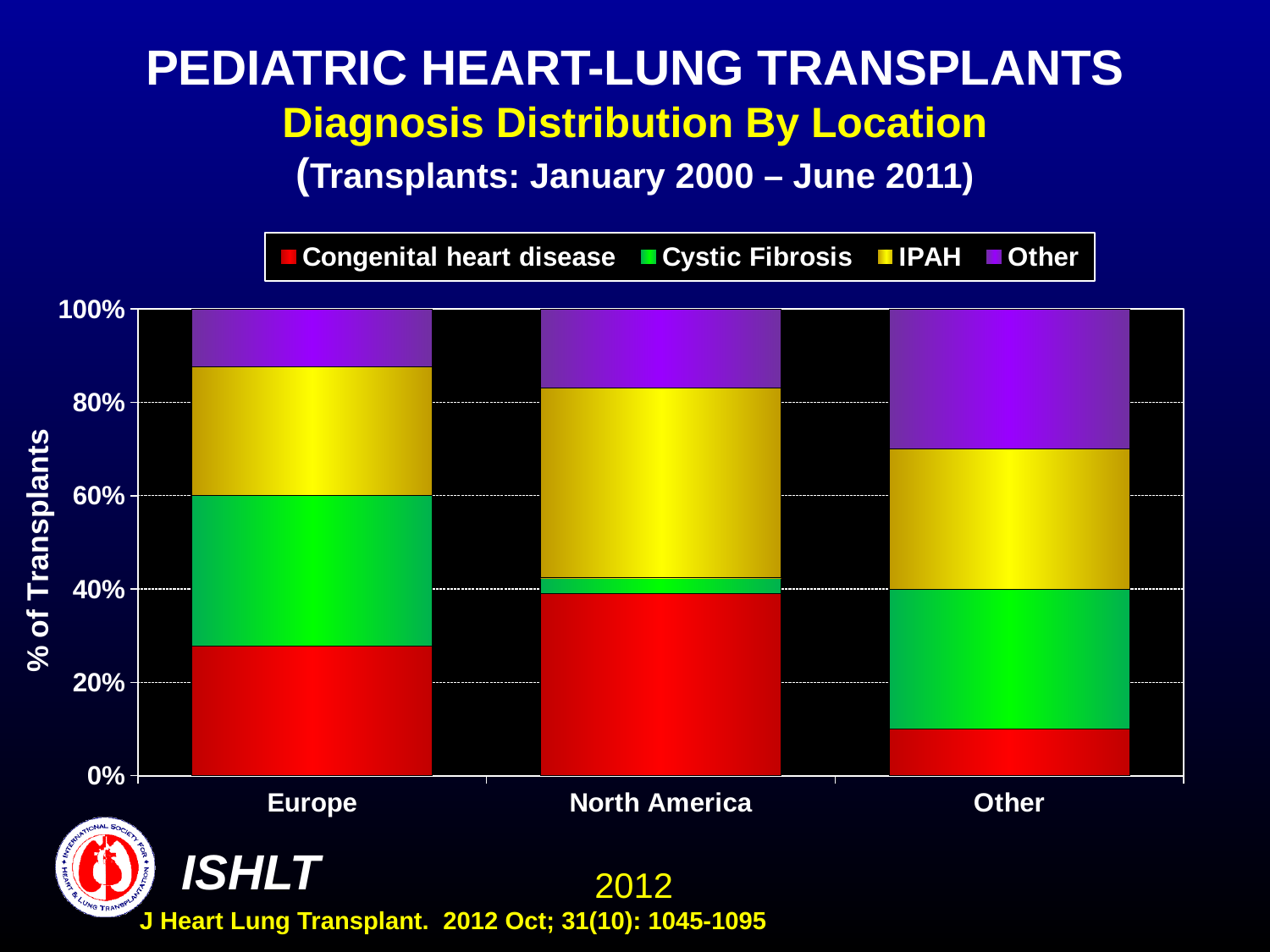
What kind of chart is shown on the slide? Stacked bar chart Is the Cystic Fibrosis share larger for Europe or for North America? Europe How many locations are shown on the x axis of the chart? 3 What is the label on the y axis of the chart? % of Transplants How many diagnosis series does the legend list? 4 What is the total of each stacked bar in the chart? 100% Which location has the largest 'Other' diagnosis share? Other Is the Congenital heart disease share for Europe greater or less than 40%? less Which location has the largest Congenital heart disease share? North America Is the Congenital heart disease share for the Other location greater or less than 20%? less Which location has the smallest Congenital heart disease share? Other Which location has the smallest Cystic Fibrosis share? North America